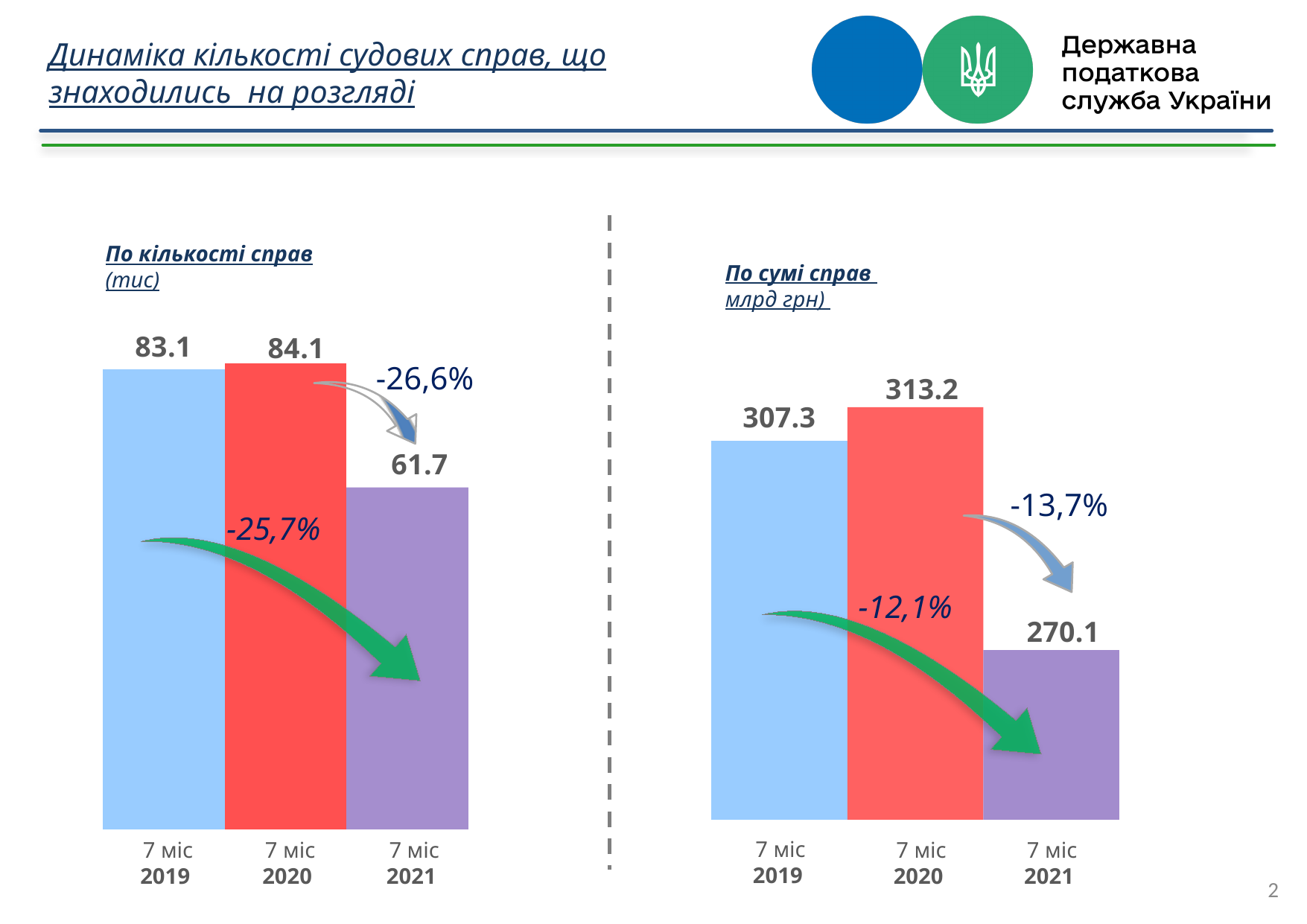
In the right chart (По сумі справ), what is the value for 7 міс 2021? 270.1 What type of chart is used on the right (По сумі справ)? Bar chart In the right chart (По сумі справ), which period has the highest value? 7 міс 2020 In the right chart (По сумі справ), which is larger: the value for 7 міс 2019 or 7 міс 2021? 7 міс 2019 In the left chart (По кількості справ), what is the difference between the values for 7 міс 2020 and 7 міс 2021? 22.4 In the left chart (По кількості справ), what is the value for 7 міс 2020? 84.1 How many bars are shown in the left chart (По кількості справ)? 3 In the right chart (По сумі справ), what is the difference between the values for 7 міс 2019 and 7 міс 2021? 37.2 In the left chart (По кількості справ), what percentage change is shown between 7 міс 2020 and 7 міс 2021? -26,6% In the left chart (По кількості справ), which period has the lowest value? 7 міс 2021 In the right chart (По сумі справ), what is the value for 7 міс 2019? 307.3 In the left chart (По кількості справ), what is the value for 7 міс 2021? 61.7